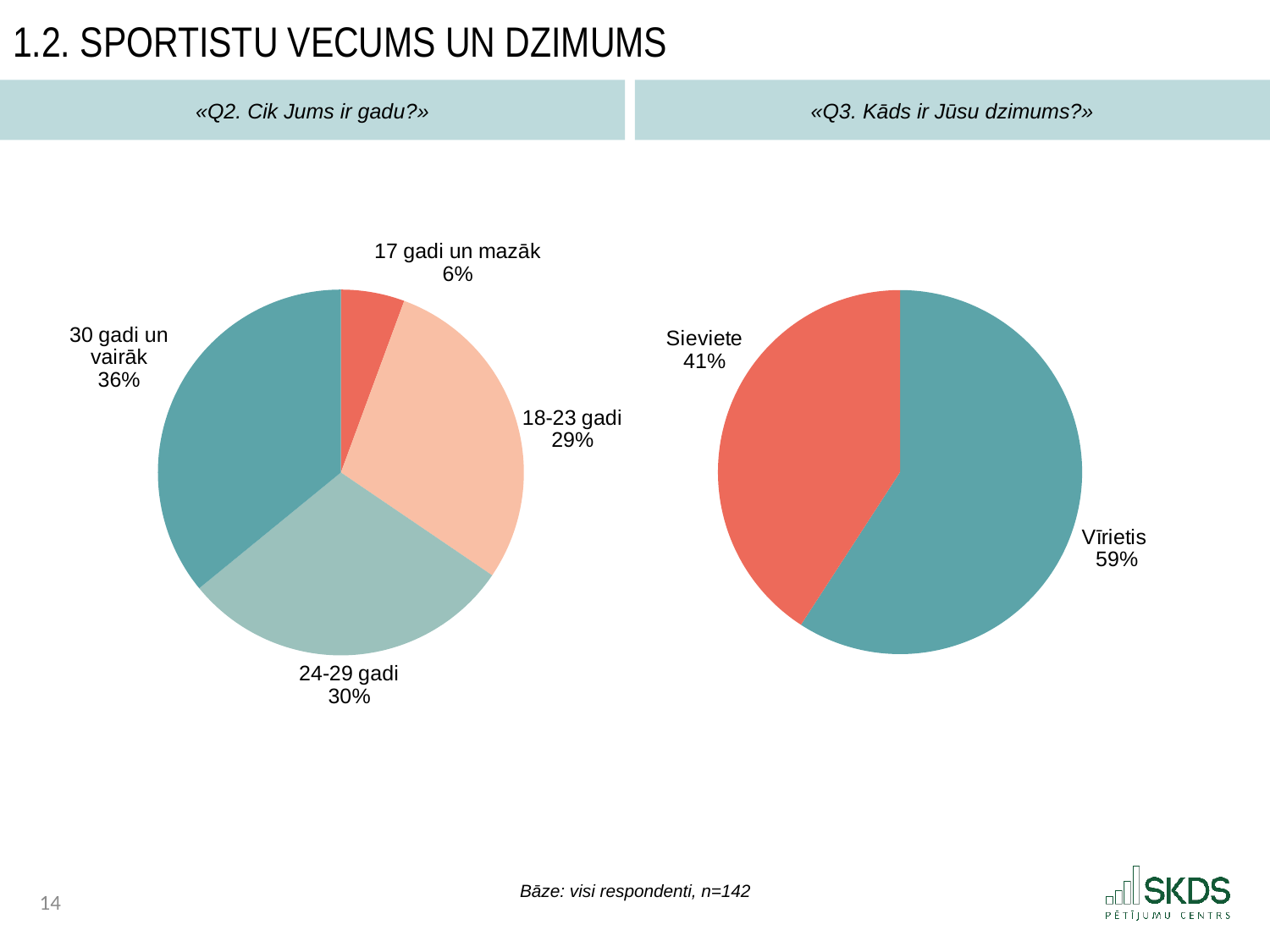
What type of chart is the left chart («Q2. Cik Jums ir gadu?»)? Pie chart In the left chart («Q2. Cik Jums ir gadu?»), how many age categories are shown? 4 In the left chart («Q2. Cik Jums ir gadu?»), which age group has the largest share? 30 gadi un vairāk In the right chart («Q3. Kāds ir Jūsu dzimums?»), what share of respondents are Sieviete? 41% In the right chart («Q3. Kāds ir Jūsu dzimums?»), what share of respondents are Vīrietis? 59% In the left chart («Q2. Cik Jums ir gadu?»), what share of respondents are 30 gadi un vairāk? 36% In the right chart («Q3. Kāds ir Jūsu dzimums?»), what is the difference in percentage points between Vīrietis and Sieviete? 18 In the left chart («Q2. Cik Jums ir gadu?»), which age group has the smallest share? 17 gadi un mazāk In the left chart («Q2. Cik Jums ir gadu?»), what is the difference in percentage points between 24-29 gadi and 17 gadi un mazāk? 24 In the left chart («Q2. Cik Jums ir gadu?»), what share of respondents are 18-23 gadi? 29% What is the base (n) stated for the charts on the slide? n=142 In the right chart («Q3. Kāds ir Jūsu dzimums?»), which is larger, Vīrietis or Sieviete? Vīrietis